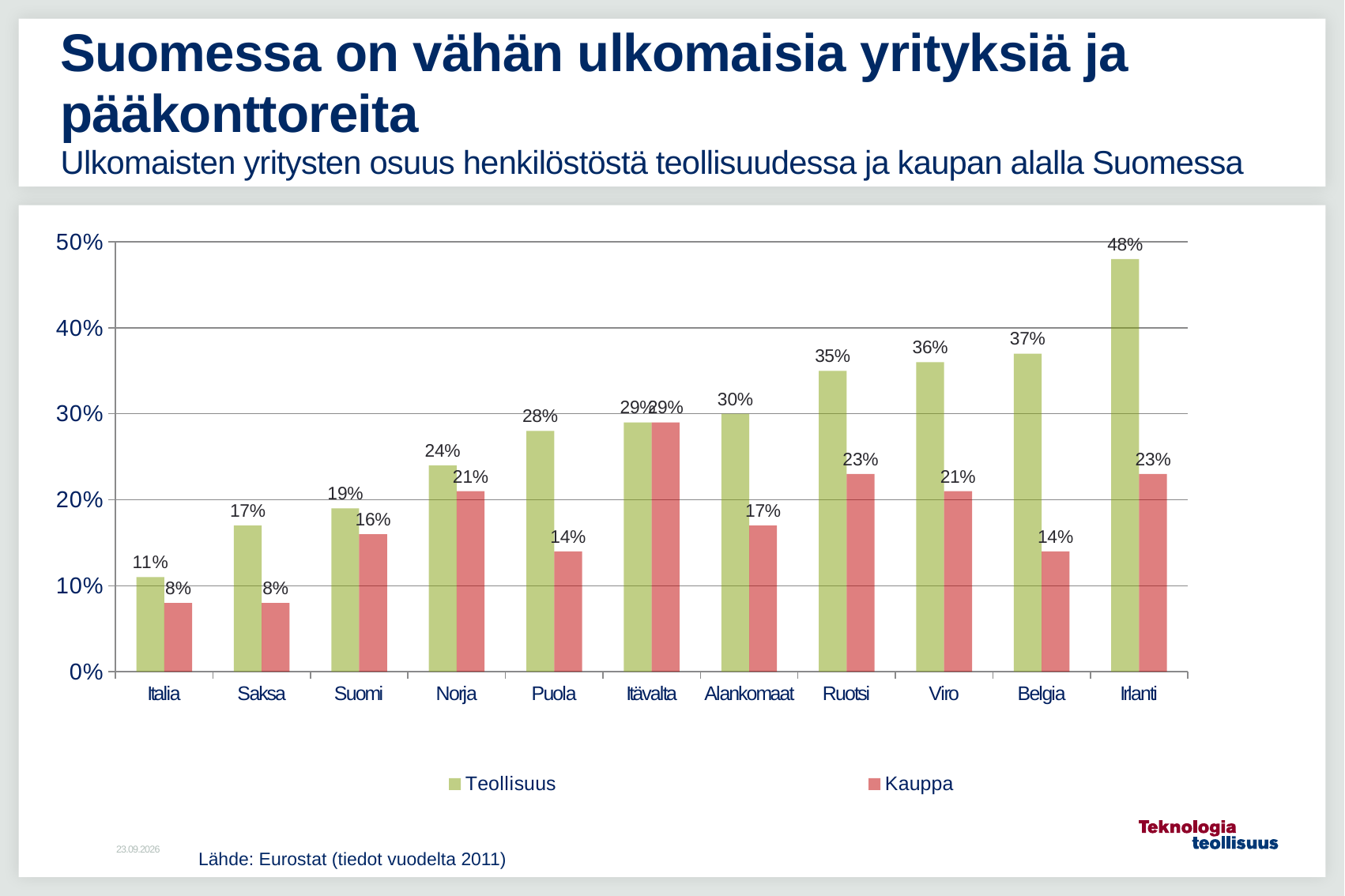
Is the Teollisuus value for Viro greater or less than 30%? greater Do the Teollisuus values rise or fall from Italia to Irlanti along the x axis? Rise What kind of chart is shown on the slide? Bar chart What is the difference between the Teollisuus and Kauppa values for Belgia? 23% Which country has the lowest Teollisuus value? Italia Which country has the highest Teollisuus value? Irlanti What is the Teollisuus value for Suomi? 19% How many countries are shown on the x axis? 11 How many series does the legend list? 2 Which is larger for Puola: the Teollisuus value or the Kauppa value? Teollisuus Which colour represents the Kauppa series in the legend? Red What is the Kauppa value for Ruotsi? 23%